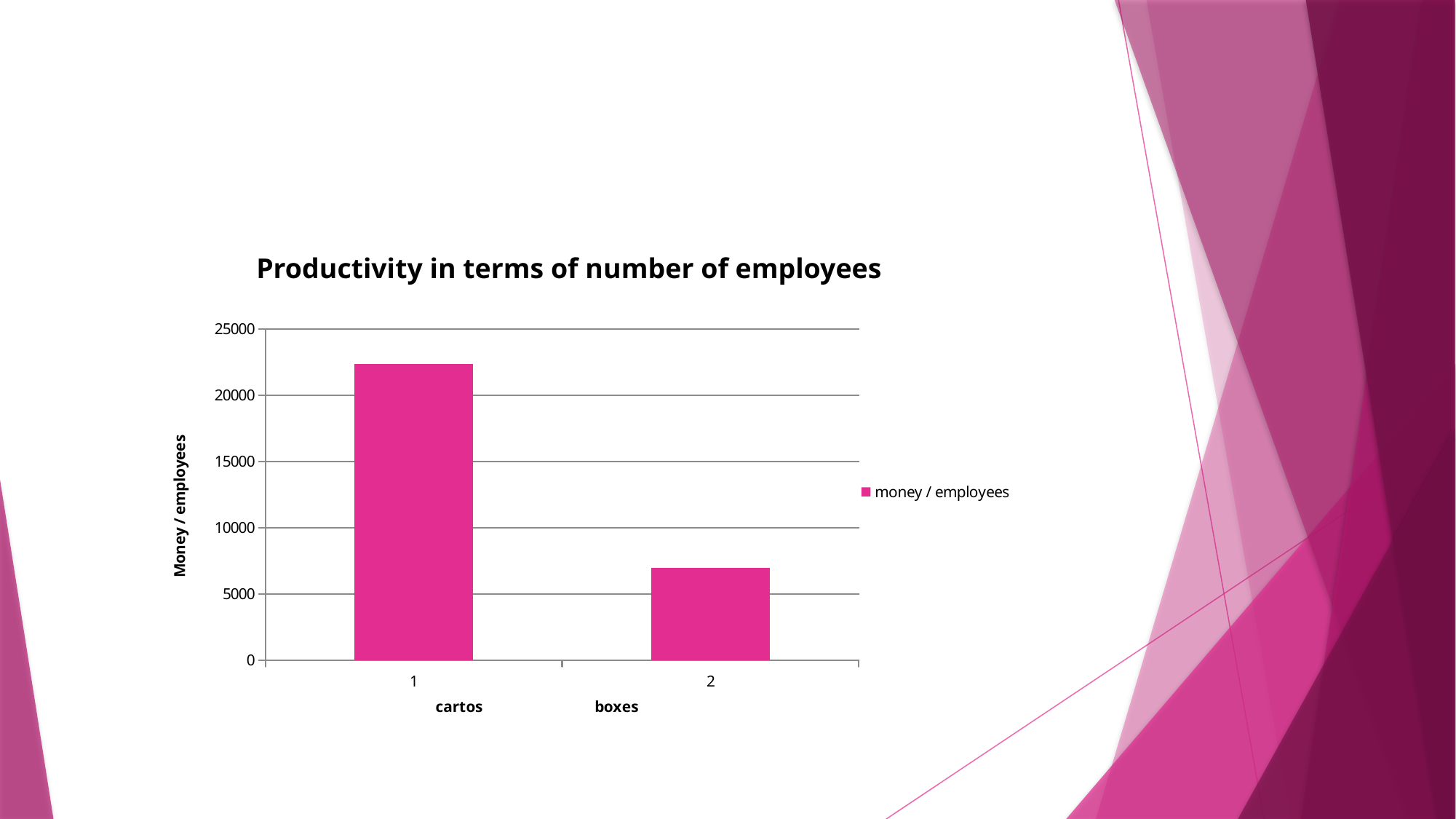
Is the value for category 1 greater or less than 20000? greater Which category has the lowest value? 2 Is the value for category 2 greater or less than 5000? greater What is the title of the chart? Productivity in terms of number of employees Is the value for category 2 greater or less than 10000? less What kind of chart is shown on the slide? bar chart What is the label on the vertical axis of the chart? Money / employees How many bars are plotted in the chart? 2 Which is larger, the value for category 1 or the value for category 2? category 1 Which category has the highest value? 1 How many series does the legend list? 1